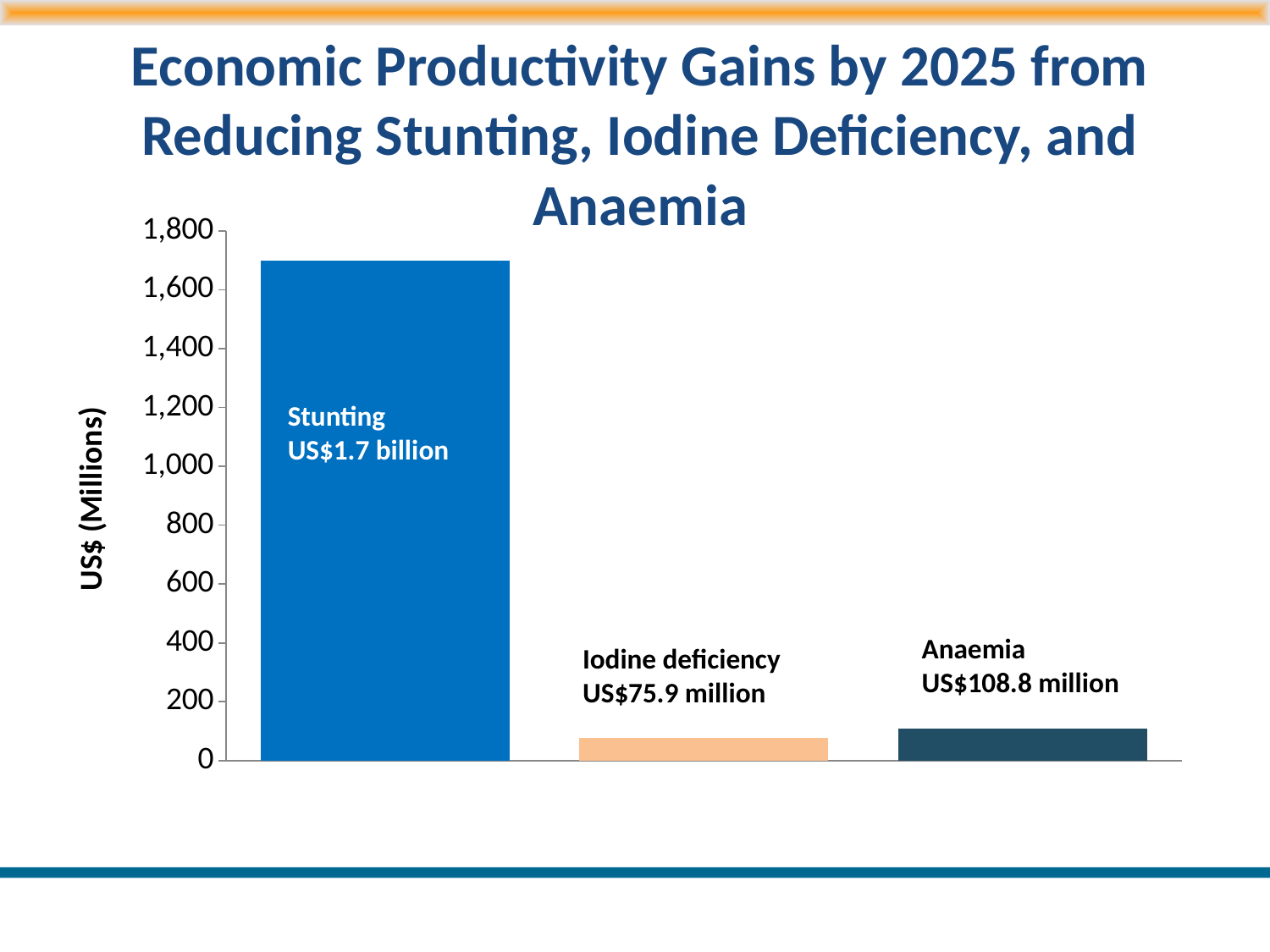
Which has a larger economic productivity gain, Anaemia or Iodine deficiency? Anaemia Is the value of the Stunting bar greater or less than 1,600? greater What is the economic productivity gain shown for Iodine deficiency? US$75.9 million Which category has the lowest economic productivity gain? Iodine deficiency Is the value of the Anaemia bar greater or less than 200? less Which category has the highest economic productivity gain? Stunting What is the difference between the gains for Anaemia and Iodine deficiency? US$32.9 million What is the economic productivity gain shown for Anaemia? US$108.8 million How many categories are shown in the chart? 3 What is the economic productivity gain shown for Stunting? US$1.7 billion What kind of chart is shown on the slide? Bar chart What is the label of the vertical axis? US$ (Millions)